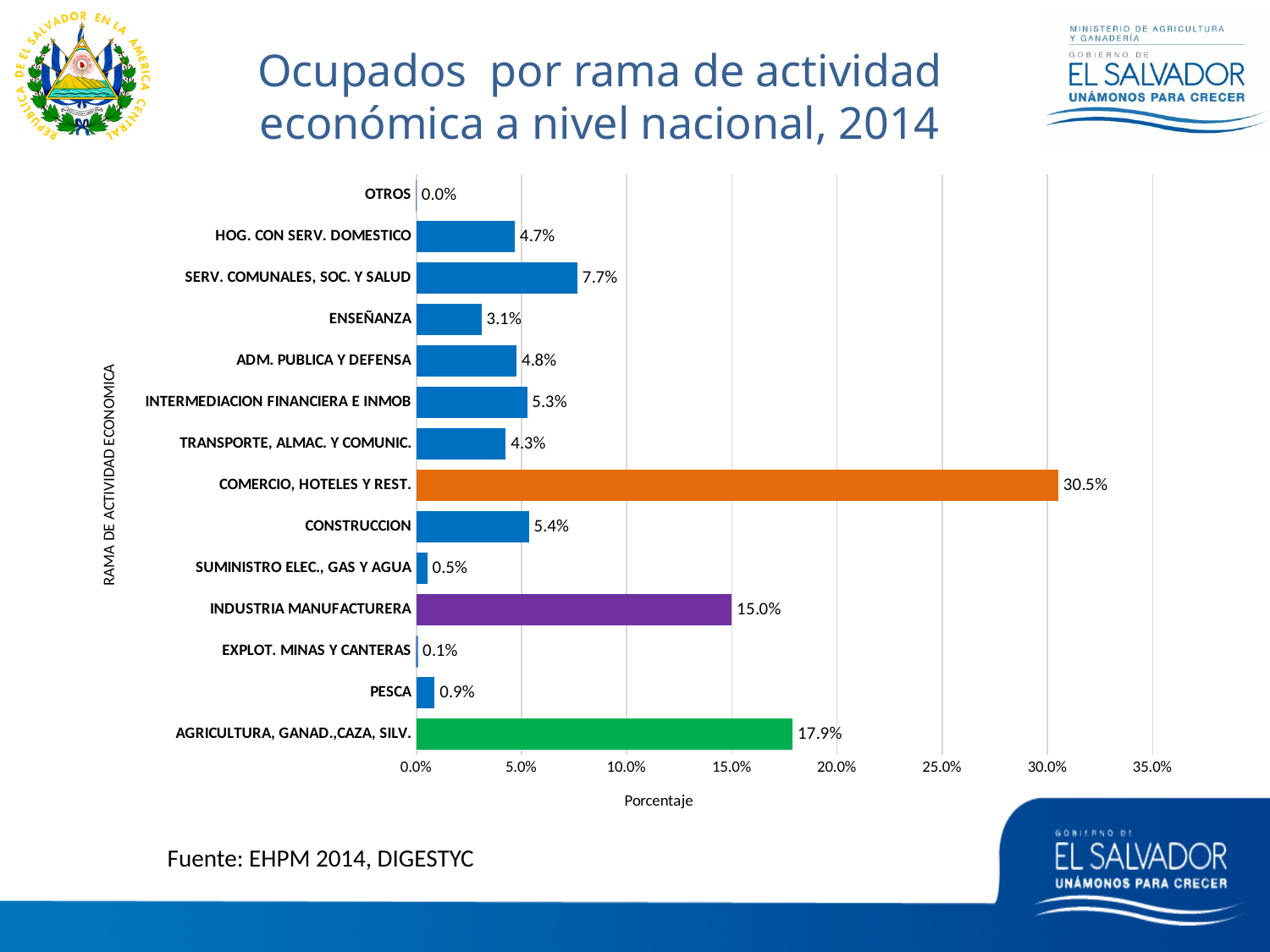
What is the value for COMERCIO, HOTELES Y REST.? 30.5% What is the value for INDUSTRIA MANUFACTURERA? 15.0% Which is larger, SERV. COMUNALES, SOC. Y SALUD or CONSTRUCCION? SERV. COMUNALES, SOC. Y SALUD What is the title of the chart? Ocupados por rama de actividad económica a nivel nacional, 2014 Is the value for INDUSTRIA MANUFACTURERA greater or less than 10.0%? greater What kind of chart is shown? bar chart How many categories are shown on the chart? 14 Which category has the highest value? COMERCIO, HOTELES Y REST. What is the value for PESCA? 0.9% What is the difference between COMERCIO, HOTELES Y REST. and AGRICULTURA, GANAD.,CAZA, SILV.? 12.6% What is the value for AGRICULTURA, GANAD.,CAZA, SILV.? 17.9% Which category has the lowest value? OTROS